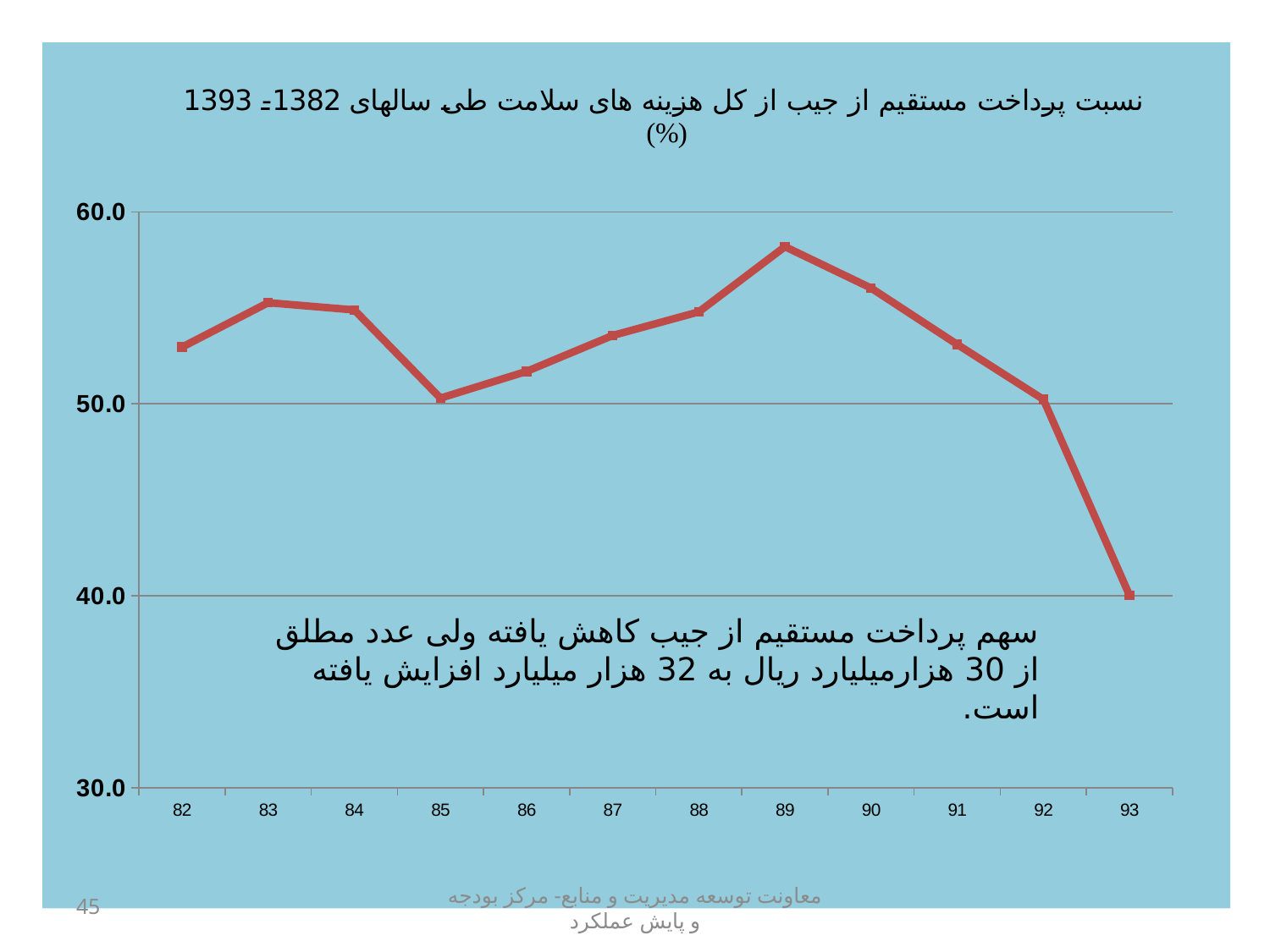
Is the value for year 93 greater or less than 50? less What kind of chart is shown on the slide? line chart How many years (data points) are plotted along the x axis? 12 Which year has the lowest value on the chart? 93 Which year has the highest value on the chart? 89 Is the value for year 91 greater or less than 60? less What is the lowest value shown on the y axis? 30.0 Which year has the larger value, 83 or 85? 83 Do the values rise or fall from year 89 to year 93? fall Which year has the larger value, 90 or 92? 90 Is the value for year 89 greater or less than 50? greater